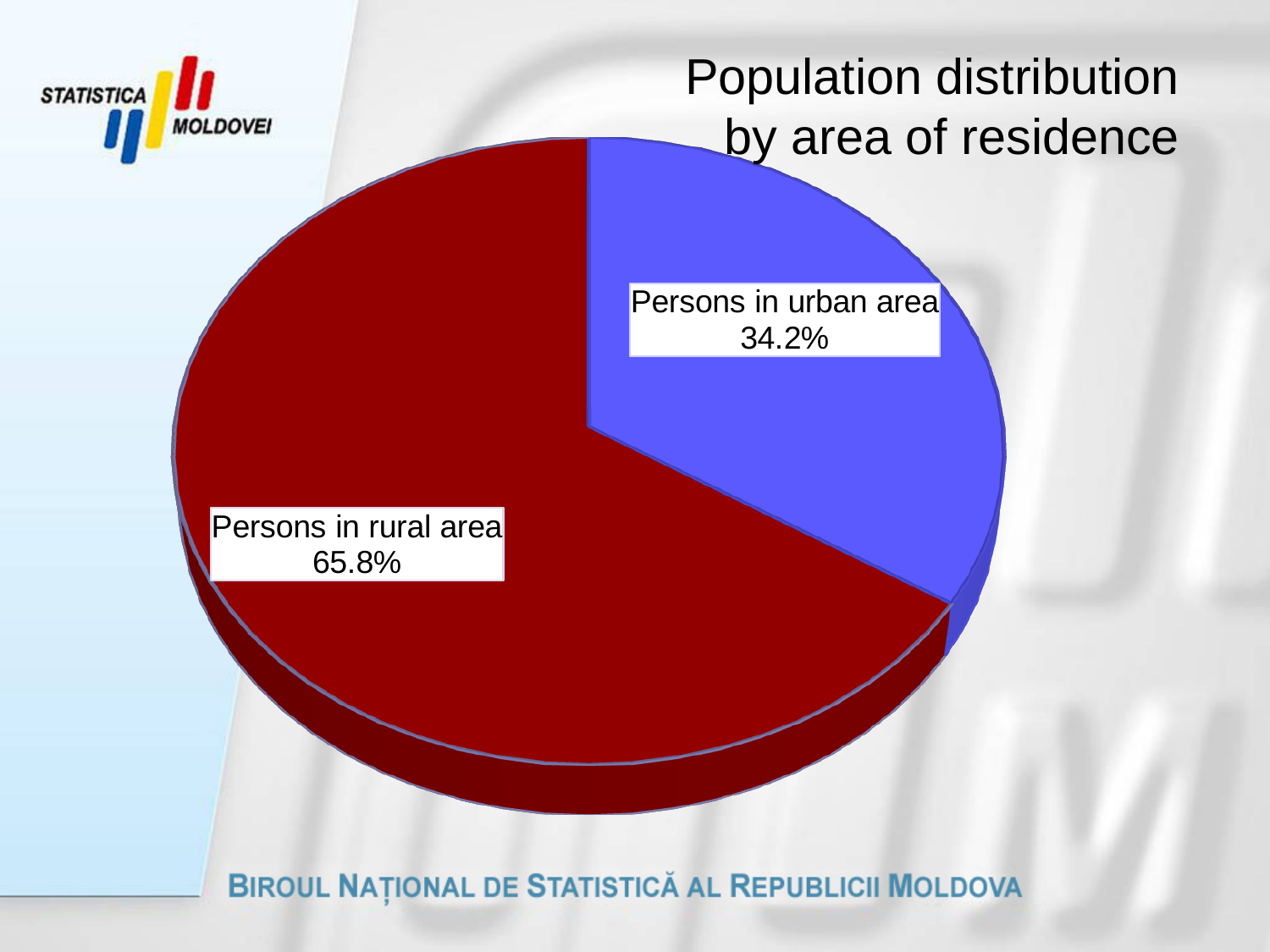
What share of the population lives in rural areas according to the pie chart? 65.8% Which category has the smallest slice of the pie chart? Persons in urban area What share of the population lives in urban areas according to the pie chart? 34.2% What colour is the slice for persons in urban areas? Blue Which is larger: the share of persons in urban areas or the share of persons in rural areas? Persons in rural area How many categories are shown in the pie chart? 2 What is the title of the chart? Population distribution by area of residence What is the difference in percentage points between the rural and urban shares? 31.6 Is the share of persons in rural areas greater or less than 50%? greater Which category has the largest slice of the pie chart? Persons in rural area What type of chart is shown on the slide? Pie chart